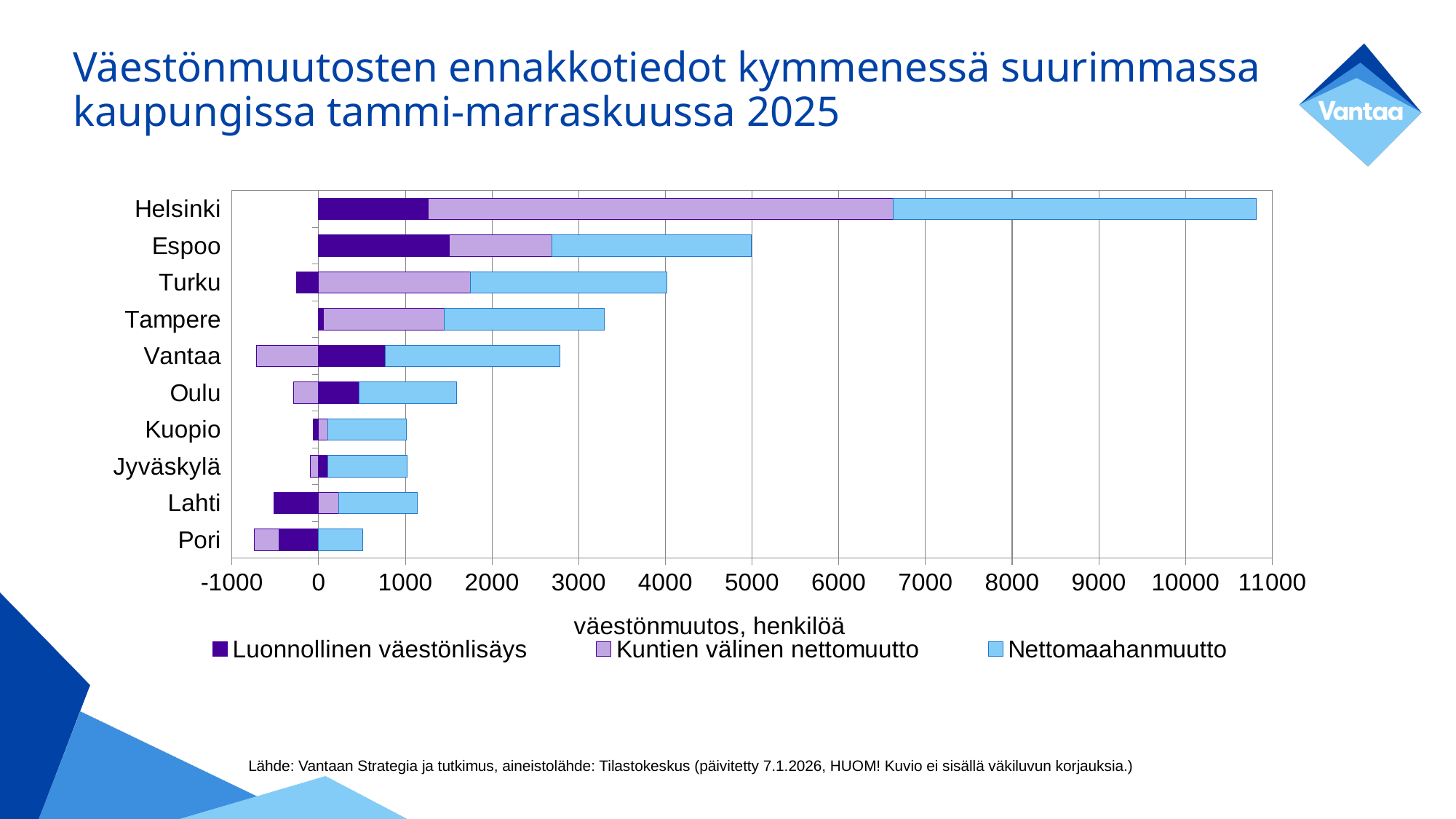
What is the title of the x axis? väestönmuutos, henkilöä Which city's bar extends the least to the right (smallest total population change)? Pori Is the Kuntien välinen nettomuutto value for Vantaa greater or less than 0? less How many cities are listed on the chart? 10 Is the right end of the Vantaa bar greater or less than 3000? less Which city has the longest bar (largest total population change)? Helsinki How many series does the legend list? 3 Is the right end of the Helsinki bar greater or less than 10000? greater What kind of chart is shown on the slide? Stacked bar chart Which city has a longer bar, Helsinki or Espoo? Helsinki Which legend entry is shown in light blue? Nettomaahanmuutto